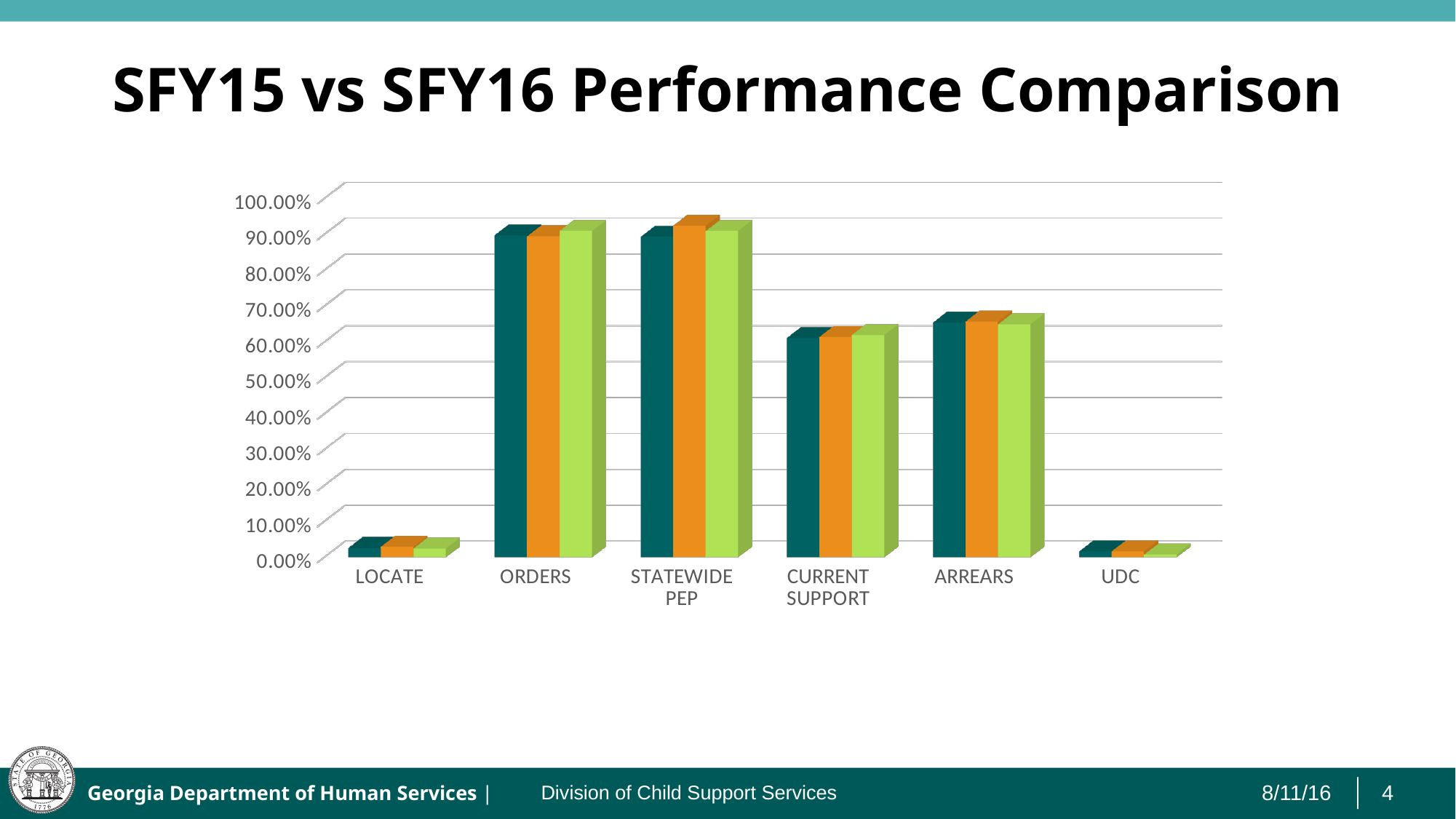
How many bars are plotted for each category in the chart? 3 Which category has higher values, ORDERS or CURRENT SUPPORT? ORDERS What is the title of the slide containing the chart? SFY15 vs SFY16 Performance Comparison Are the values for ARREARS greater or less than 70.00%? less Are the values for LOCATE greater or less than 10.00%? less What kind of chart is shown on the slide? bar chart Are the values for UDC greater or less than 10.00%? less How many categories are shown on the x axis of the chart? 6 Which category has higher values, ARREARS or CURRENT SUPPORT? ARREARS